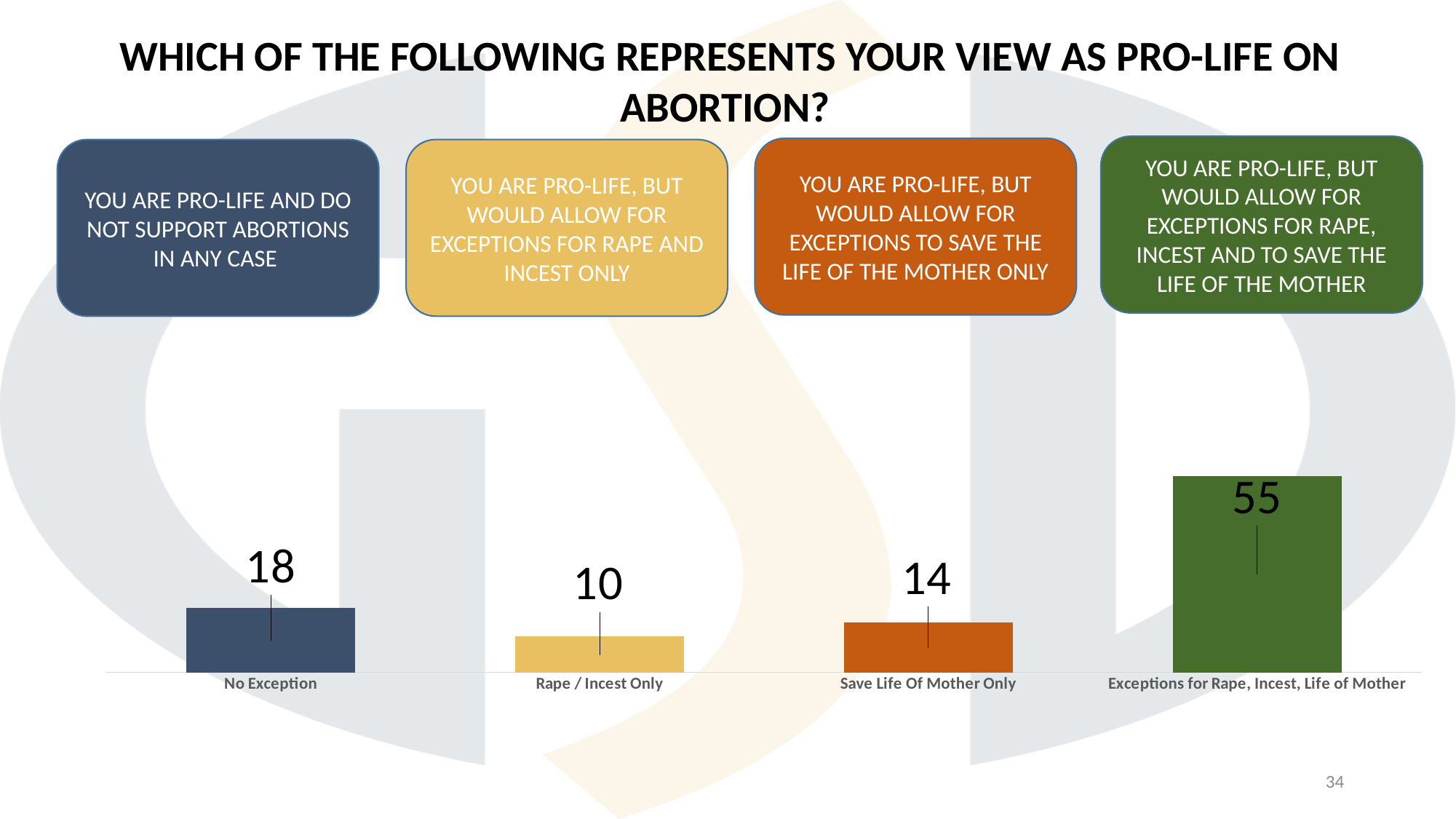
What colour is the bar for Exceptions for Rape, Incest, Life of Mother? Green What is the difference between the values for Exceptions for Rape, Incest, Life of Mother and No Exception? 37 How many categories are shown in the chart? 4 What is the value for No Exception? 18 Which category has the highest value? Exceptions for Rape, Incest, Life of Mother Which is larger, the value for No Exception or the value for Save Life Of Mother Only? No Exception What is the difference between the values for No Exception and Save Life Of Mother Only? 4 What is the value for Save Life Of Mother Only? 14 What kind of chart is shown on the slide? Bar chart What is the value for Rape / Incest Only? 10 What is the value for Exceptions for Rape, Incest, Life of Mother? 55 Which category has the lowest value? Rape / Incest Only